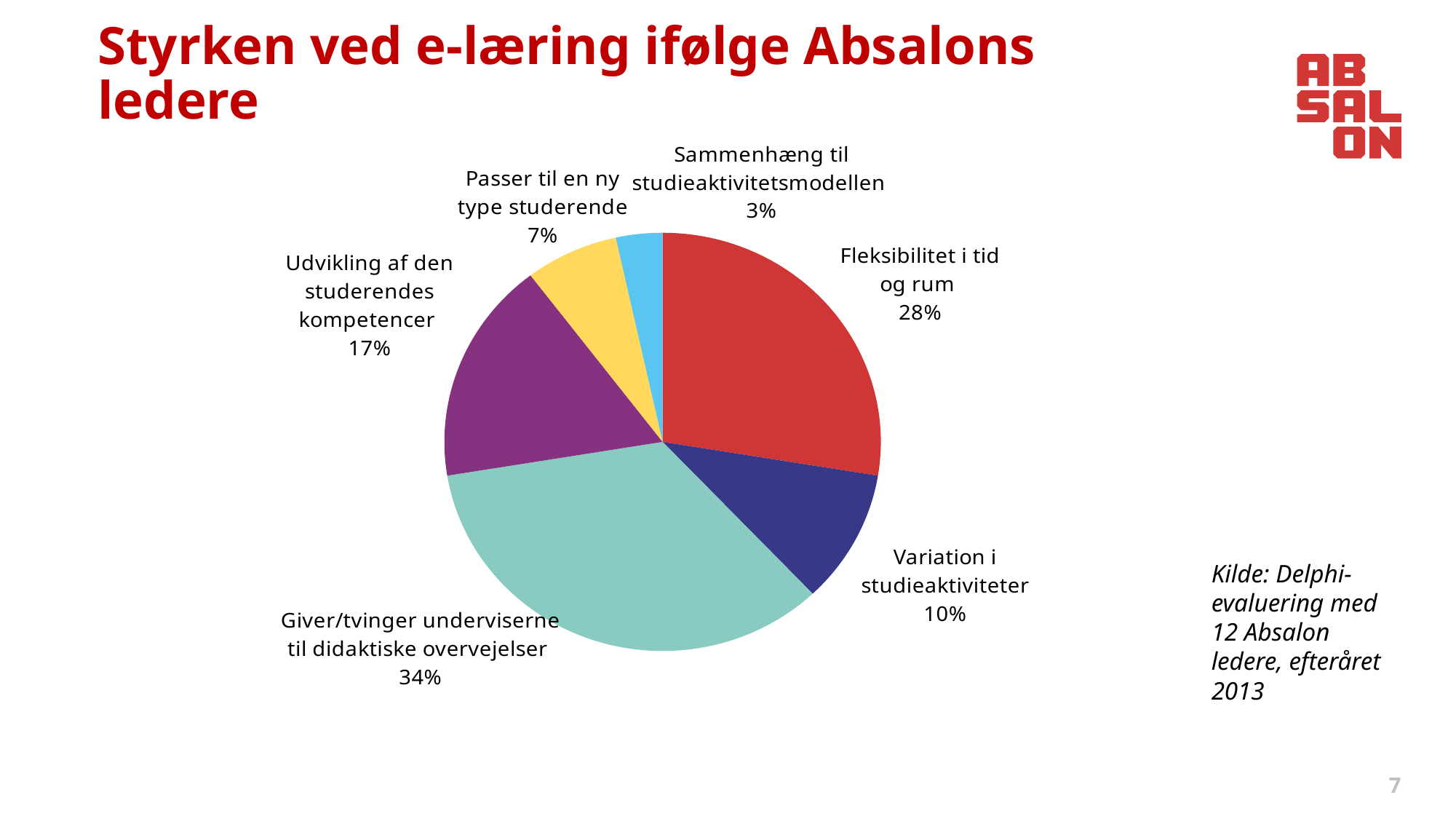
Which is larger, "Udvikling af den studerendes kompetencer" or "Variation i studieaktiviteter"? Udvikling af den studerendes kompetencer Which category has the smallest slice of the pie? Sammenhæng til studieaktivitetsmodellen What share of the pie does "Fleksibilitet i tid og rum" represent? 28% What kind of chart is shown on the slide? Pie chart What is the difference in percentage points between "Giver/tvinger underviserne til didaktiske overvejelser" and "Fleksibilitet i tid og rum"? 6 percentage points What colour is the slice for "Passer til en ny type studerende"? Yellow What share of the pie does "Giver/tvinger underviserne til didaktiske overvejelser" represent? 34% What is the value shown for "Udvikling af den studerendes kompetencer"? 17% Which category has the largest slice of the pie? Giver/tvinger underviserne til didaktiske overvejelser What is the value shown for "Sammenhæng til studieaktivitetsmodellen"? 3% How many categories are shown in the pie chart? 6 What is the value shown for "Variation i studieaktiviteter"? 10%